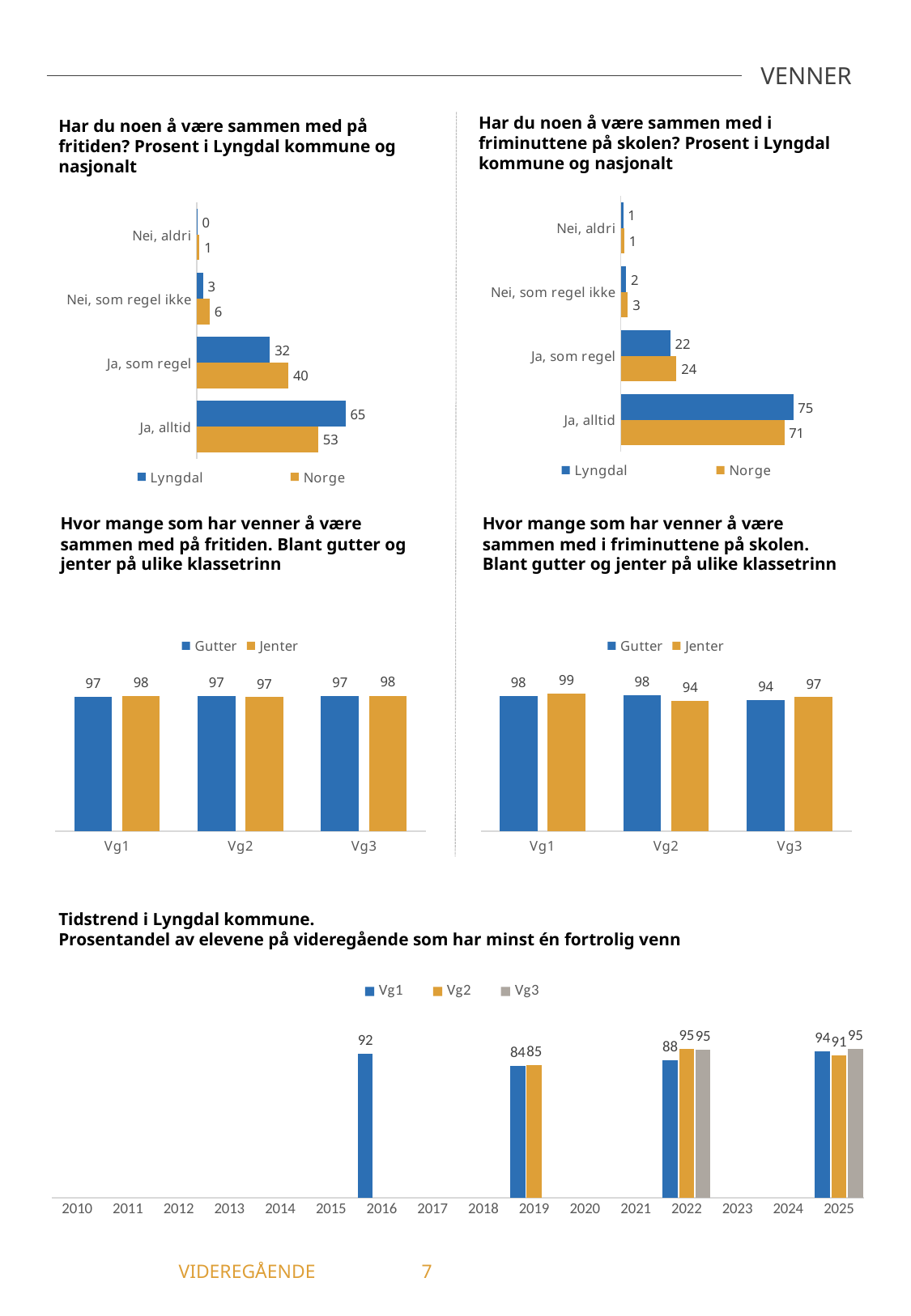
In the top-left chart (Har du noen å være sammen med på fritiden?), what is the difference between the Norge and Lyngdal values for 'Ja, som regel'? 8 In the top-right chart (Har du noen å være sammen med i friminuttene på skolen?), what is the Norge value for 'Ja, alltid'? 71 In the top-right chart (Har du noen å være sammen med i friminuttene på skolen?), which is larger for 'Ja, som regel': Lyngdal or Norge? Norge In the middle-left chart (venner å være sammen med på fritiden, gutter og jenter), what is the value for Jenter at Vg2? 97 In the middle-right chart (venner i friminuttene på skolen, gutter og jenter), which class level has the highest Jenter value? Vg1 In the middle-right chart (venner i friminuttene på skolen, gutter og jenter), what is the value for Gutter at Vg3? 94 In the top-right chart (Har du noen å være sammen med i friminuttene på skolen?), how many response categories are shown? 4 What kind of chart is the bottom chart (Tidstrend i Lyngdal kommune)? Bar chart In the bottom chart (Tidstrend i Lyngdal kommune), what is the Vg1 value for 2016? 92 In the bottom chart (Tidstrend i Lyngdal kommune), what is the difference between the Vg2 and Vg1 values in 2022? 7 In the bottom chart (Tidstrend i Lyngdal kommune), how many series does the legend list? 3 In the top-left chart (Har du noen å være sammen med på fritiden?), what is the Lyngdal value for 'Ja, alltid'? 65